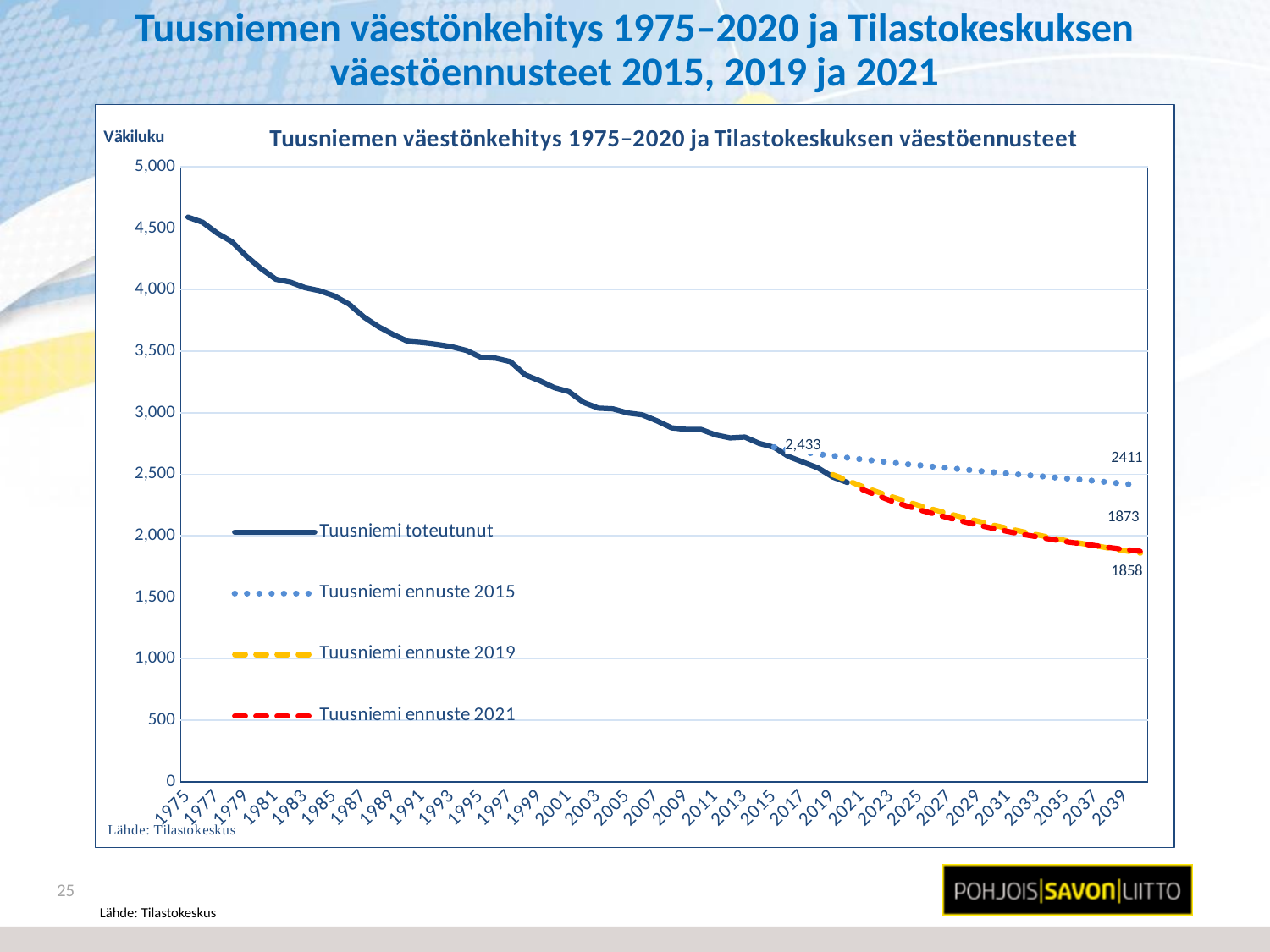
Which forecast series ends at the highest value at the right end of the chart? Tuusniemi ennuste 2015 How many series does the chart legend list? 4 What is the final labelled value of the Tuusniemi ennuste 2021 series? 1873 Which forecast series ends at the lowest value at the right end of the chart? Tuusniemi ennuste 2019 What is the final labelled value of the Tuusniemi ennuste 2019 series? 1858 Is the value of the Tuusniemi toteutunut series in 1975 greater or less than 4,500? greater What kind of chart is shown on the slide? line chart What is the difference between the final labelled values of the ennuste 2015 series (2411) and the ennuste 2021 series (1858)? 538 Does the Tuusniemi toteutunut series rise or fall from 1975 to 2020? fall What is the final labelled value of the Tuusniemi ennuste 2015 series? 2411 What is the difference between the final labelled values of the ennuste 2019 series (1873) and the ennuste 2021 series (1858)? 15 What is the label on the vertical axis of the chart? Väkiluku